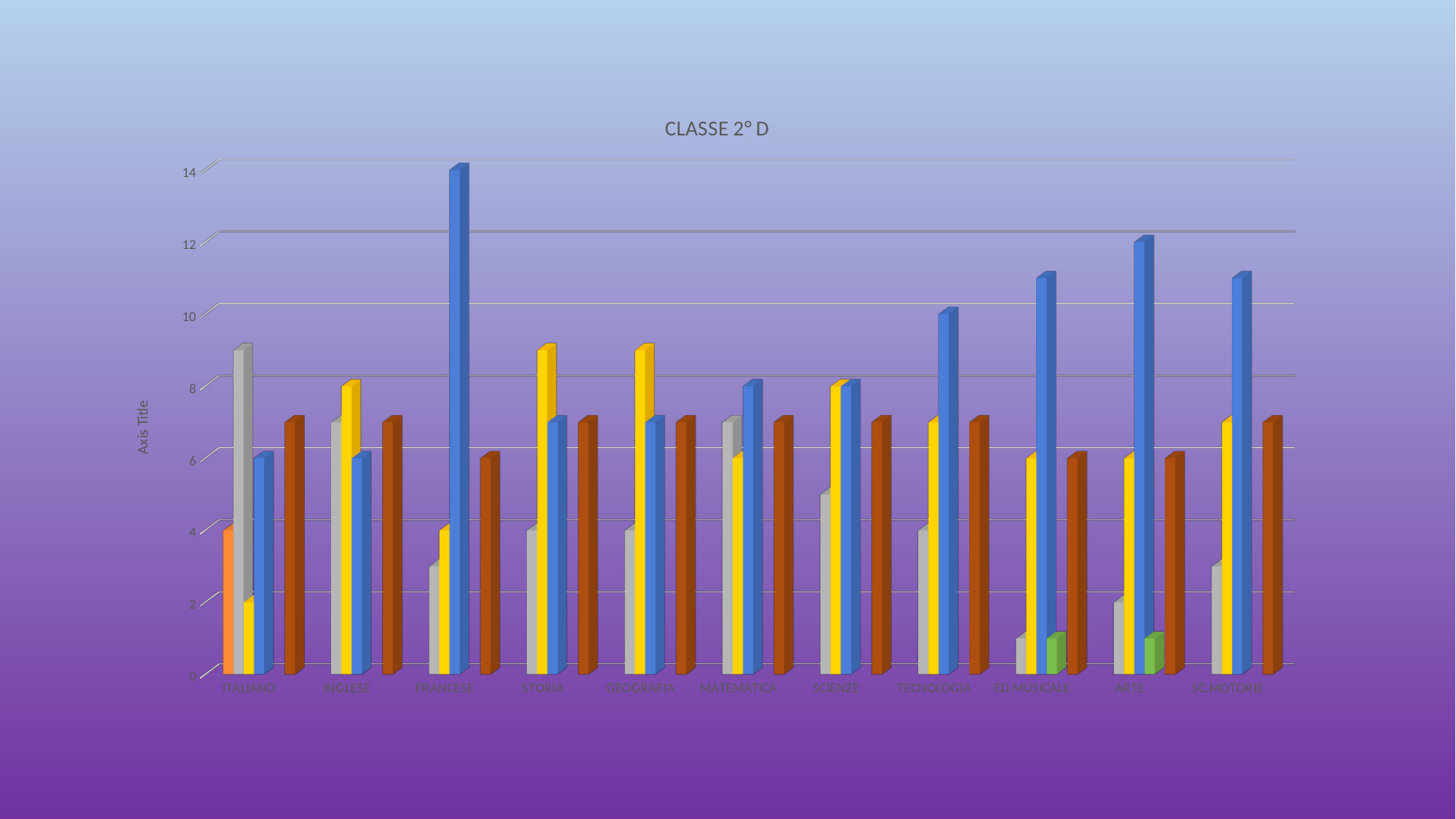
What is the title of the chart? CLASSE 2° D Is the value of the blue bar for FRANCESE greater or less than 12? greater Is the value of the green bar for ED.MUSICALE greater or less than 2? less What kind of chart is shown on the slide? bar chart Is the value of the blue bar for ARTE greater or less than 10? greater How many subject categories are shown along the x axis of the chart? 11 Which is larger, the yellow bar for STORIA or the yellow bar for FRANCESE? STORIA What text is shown as the vertical axis title of the chart? Axis Title Which is larger, the blue bar for FRANCESE or the blue bar for ARTE? FRANCESE Which category has the tallest blue bar? FRANCESE